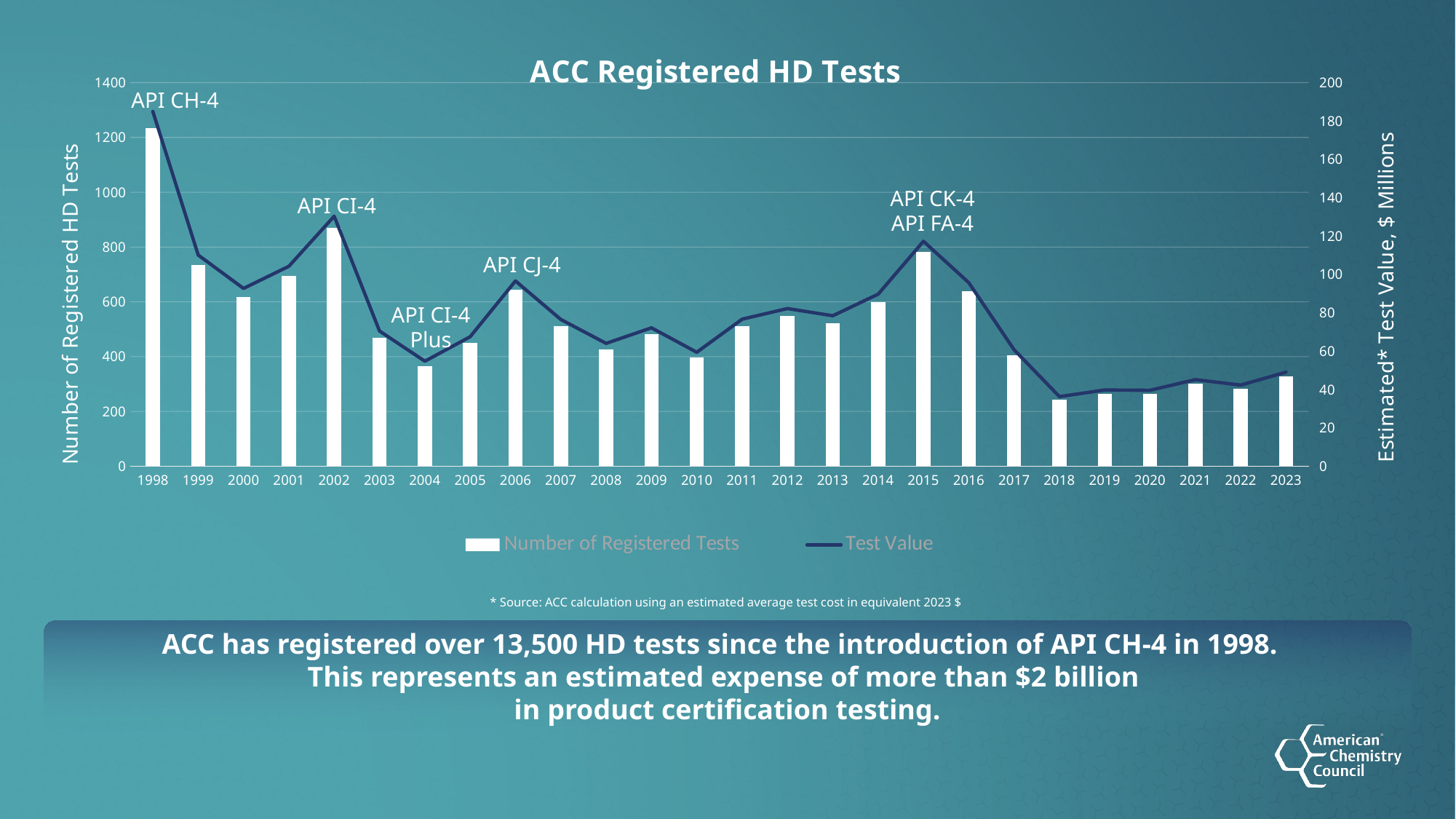
Which year has more registered tests, 2015 or 2016? 2015 Which year has the highest Test Value on the line series? 1998 Which year has the highest number of registered tests? 1998 How many series does the legend list? 2 Does the number of registered tests rise or fall from 2015 to 2018? fall What is the title of the chart? ACC Registered HD Tests Is the number of registered tests for 2002 greater or less than 800? greater How many years are shown on the x axis? 26 Is the number of registered tests for 1998 greater or less than 1000? greater Is the number of registered tests for 2004 greater or less than 400? less Which year has more registered tests, 2002 or 2006? 2002